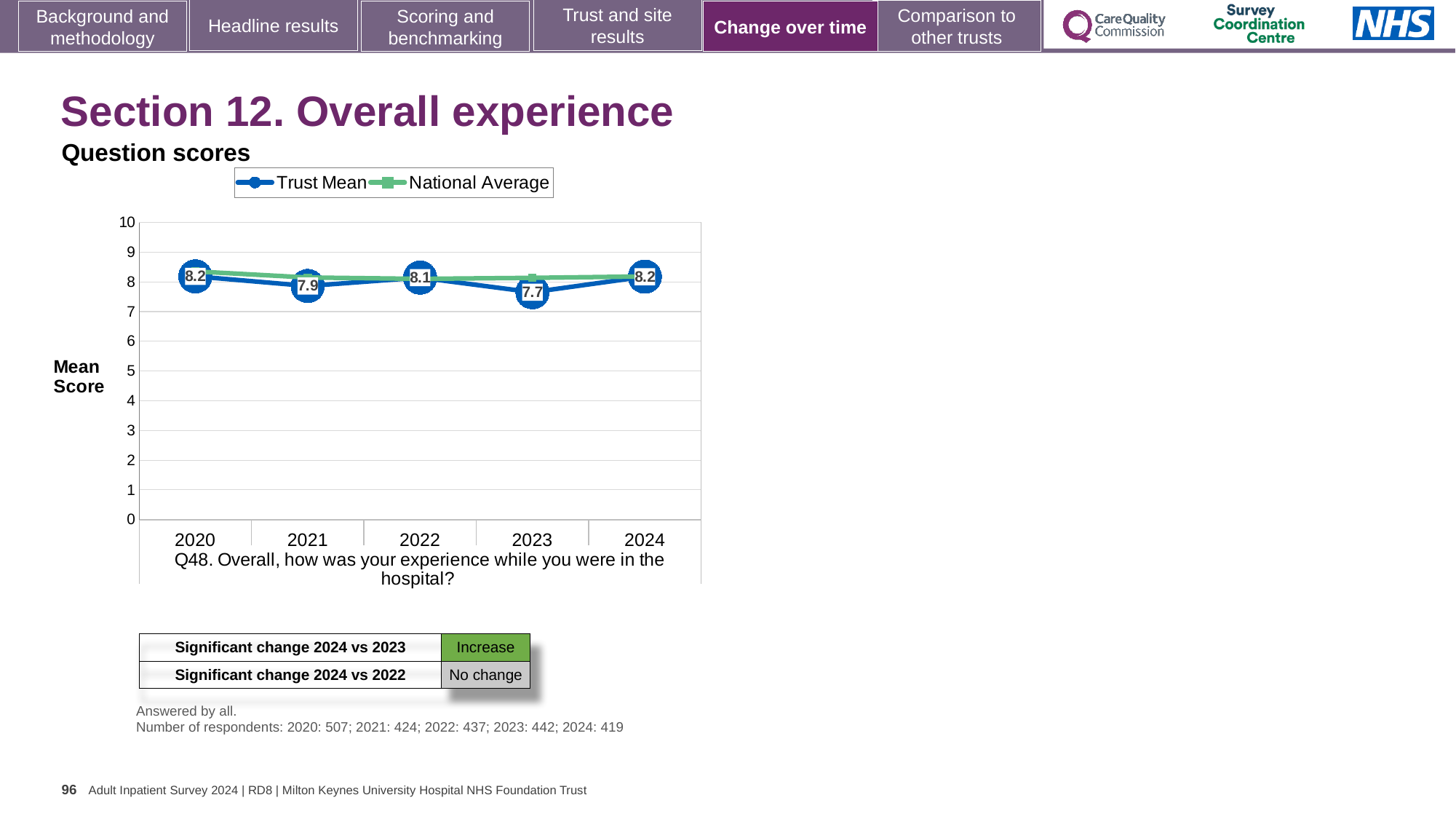
What is the Trust Mean score for 2023? 7.7 Is the National Average value for 2023 greater or less than 7? greater What is the Trust Mean score for 2020? 8.2 What is the label on the y axis of the chart? Mean Score Does the Trust Mean score rise or fall from 2023 to 2024? rise How many series does the legend list? 2 What is the Trust Mean score for 2021? 7.9 What kind of chart is shown on the slide? line chart In which year is the Trust Mean score lowest? 2023 What is the difference between the Trust Mean scores for 2024 and 2023? 0.5 How many years are plotted on the x axis? 5 Which year has the larger Trust Mean score, 2021 or 2022? 2022